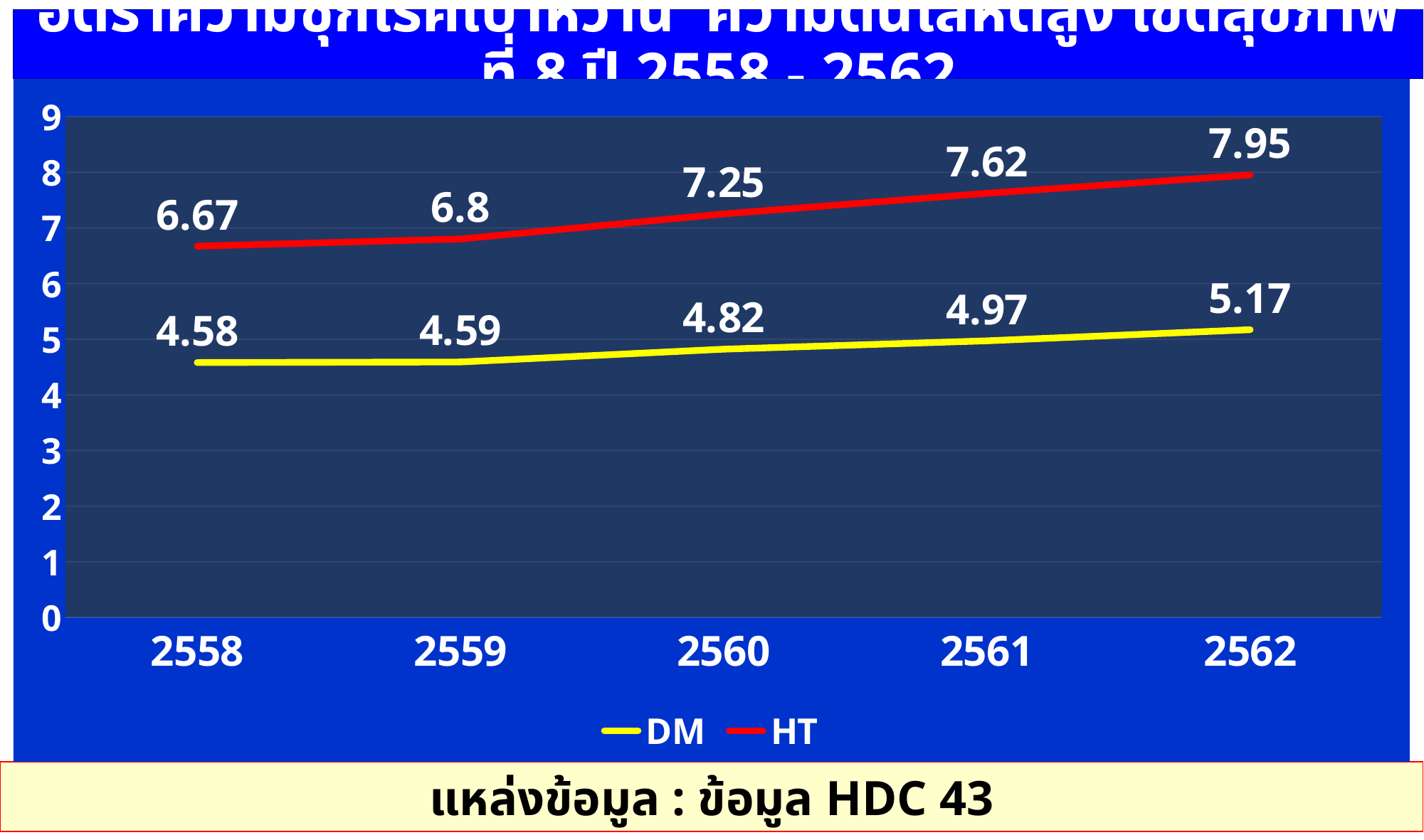
How many years are shown on the x axis? 5 How many series does the legend list? 2 What is the difference between the HT and DM values in 2561? 2.65 What is the DM value for 2562? 5.17 Does the DM series rise or fall from 2558 to 2562? Rise In which year is the DM value lowest? 2558 What kind of chart is shown on the slide? Line chart What is the HT value for 2560? 7.25 What is the DM value for 2558? 4.58 What is the HT value for 2559? 6.8 Which series has the larger value in 2562, DM or HT? HT In which year is the HT value highest? 2562